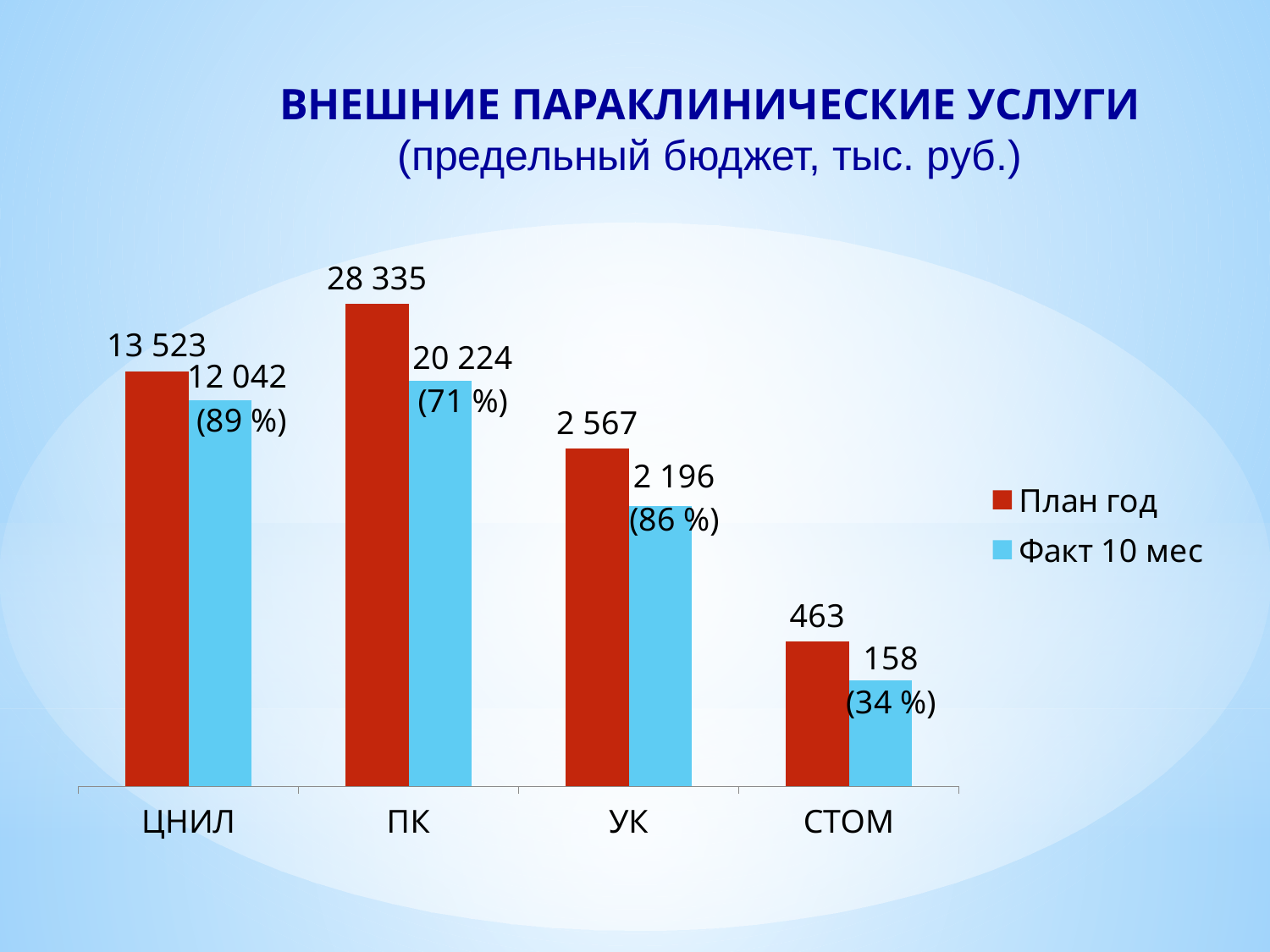
What is the value of Факт 10 мес for СТОМ? 158 What is the difference between План год and Факт 10 мес for ПК? 8 111 How many categories are shown on the x axis? 4 Which category has the highest План год value? ПК Which is larger for УК: План год or Факт 10 мес? План год What is the value of План год for ПК? 28 335 What kind of chart is shown on the slide? Bar chart What is the value of Факт 10 мес for ЦНИЛ? 12 042 How many series does the legend list? 2 Which category has the lowest Факт 10 мес value? СТОМ What percentage is shown next to the Факт 10 мес bar for УК? 86 % What is the difference between План год and Факт 10 мес for СТОМ? 305